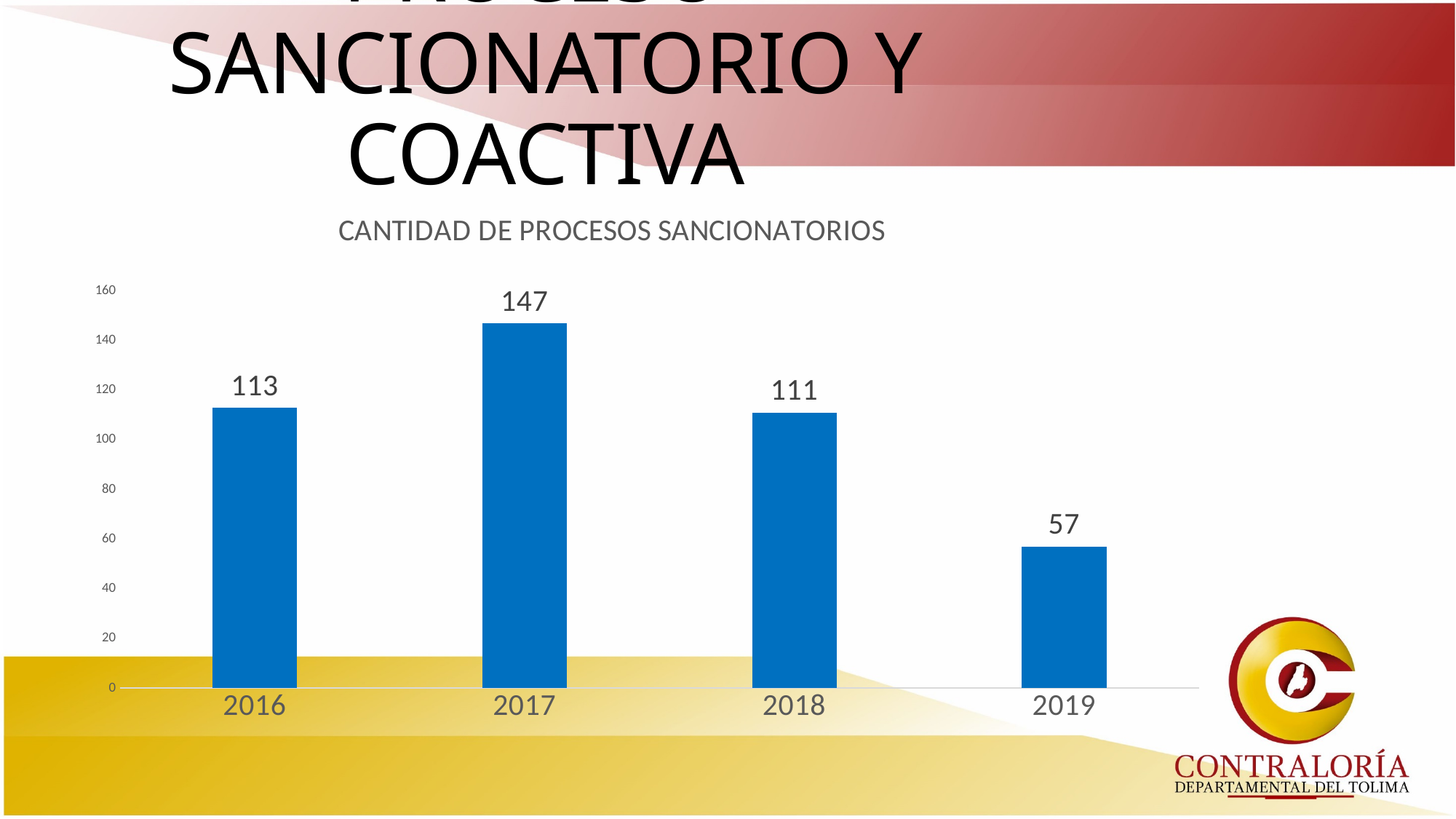
What is the value for 2018? 111 Which year has the lowest number of processes? 2019 What is the difference between the values for 2017 and 2019? 90 Which is larger, the value for 2016 or the value for 2018? 2016 What kind of chart is shown? bar chart What is the title of the chart? CANTIDAD DE PROCESOS SANCIONATORIOS What is the value for 2016? 113 Which year has the highest number of processes? 2017 What is the value for 2019? 57 How many years are shown on the chart? 4 Is the value for 2019 greater or less than 60? less What is the value for 2017? 147